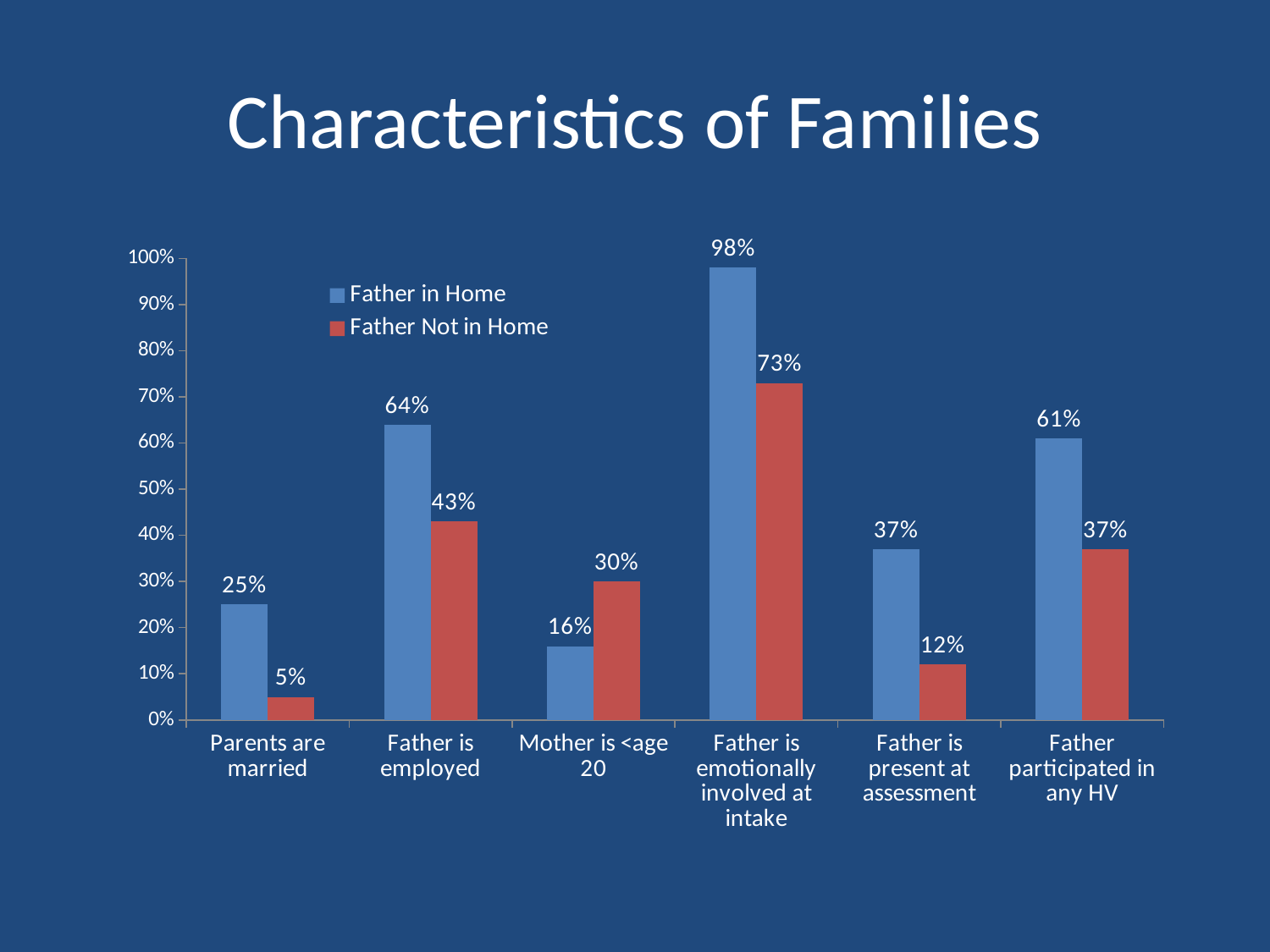
What is the value for "Father Not in Home" in the "Father is employed" category? 43% What is the difference between the "Father in Home" and "Father Not in Home" values for "Father is present at assessment"? 25% How many series does the legend list? 2 Which category has the lowest value for the "Father Not in Home" series? Parents are married What is the title of the slide? Characteristics of Families What is the value for "Father Not in Home" in the "Mother is <age 20" category? 30% Which colour represents the "Father Not in Home" series? Red How many categories are shown on the x axis? 6 What is the value for "Father in Home" in the "Parents are married" category? 25% Which category has the highest value for the "Father in Home" series? Father is emotionally involved at intake Which is larger in the "Mother is <age 20" category: "Father in Home" or "Father Not in Home"? Father Not in Home What kind of chart is shown on the slide? Bar chart